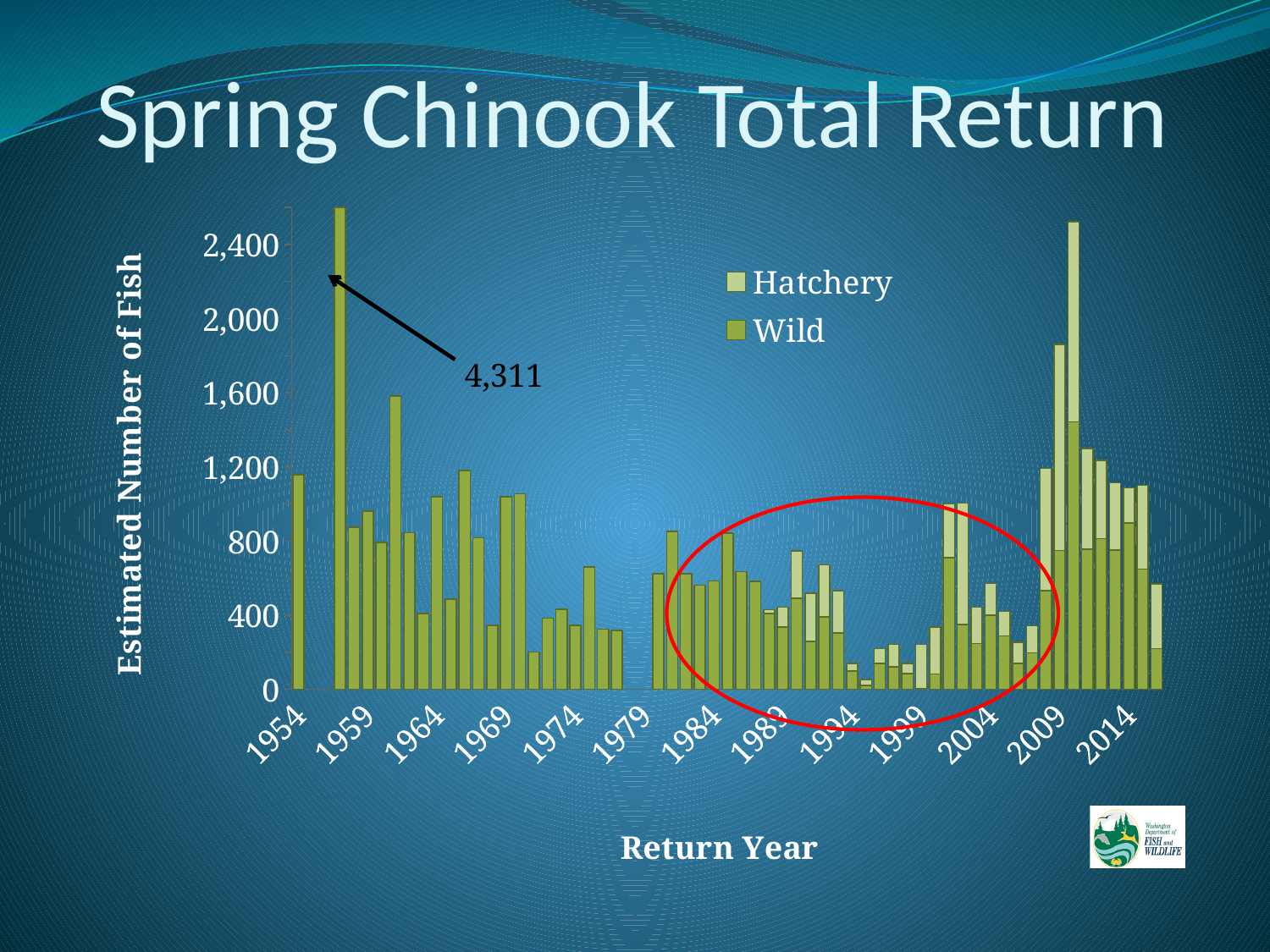
Is the value for 2004 greater or less than 800? less Which year has the larger total return, 2004 or 2009? 2009 What are the two series named in the legend? Hatchery and Wild What is the highest total return value shown on the chart? 4,311 How many series does the legend list? 2 What is the title of the chart's x axis? Return Year Is the value for 1954 greater or less than 800? greater Is the value for 2009 greater or less than 800? greater What kind of chart is shown on the slide? Bar chart What value does the annotation give for the tallest bar, which extends beyond the top of the axis? 4,311 How many year labels are printed along the x axis? 13 Which year has the larger total return, 1954 or 1974? 1954